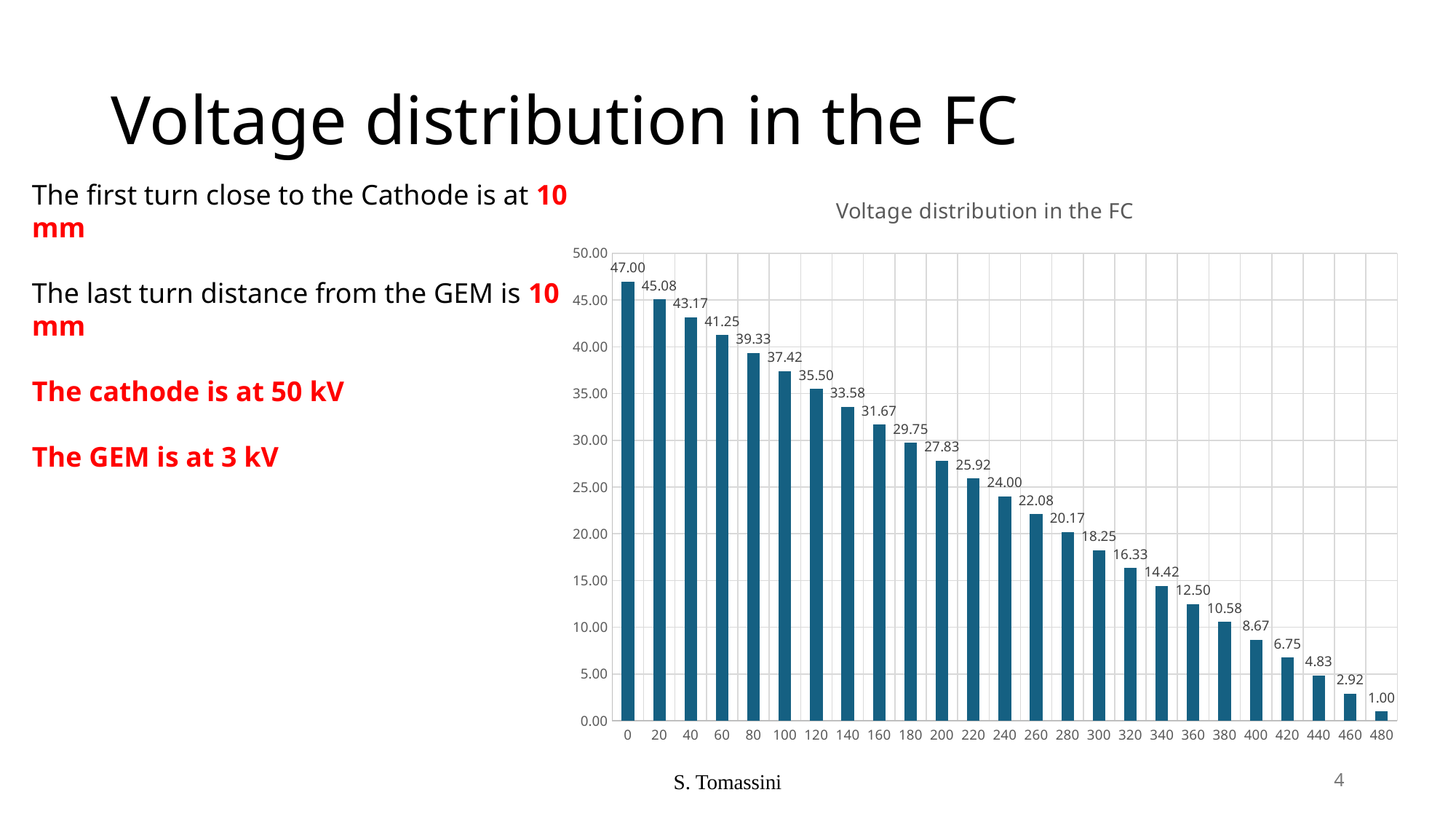
What is the title of the chart? Voltage distribution in the FC Which is larger, the value at x = 100 or the value at x = 300? x = 100 Do the values rise or fall as x increases along the x axis? Fall Which x value has the lowest bar in the chart? 480 Which x value has the highest bar in the chart? 0 What is the value at x = 0 in the chart? 47.00 What is the difference between the values at x = 0 and x = 20? 1.92 What is the value at x = 480 in the chart? 1.00 How many bars are plotted in the chart? 25 What is the value at x = 360 in the chart? 12.50 What is the value at x = 240 in the chart? 24.00 What kind of chart is shown on the slide? Bar chart